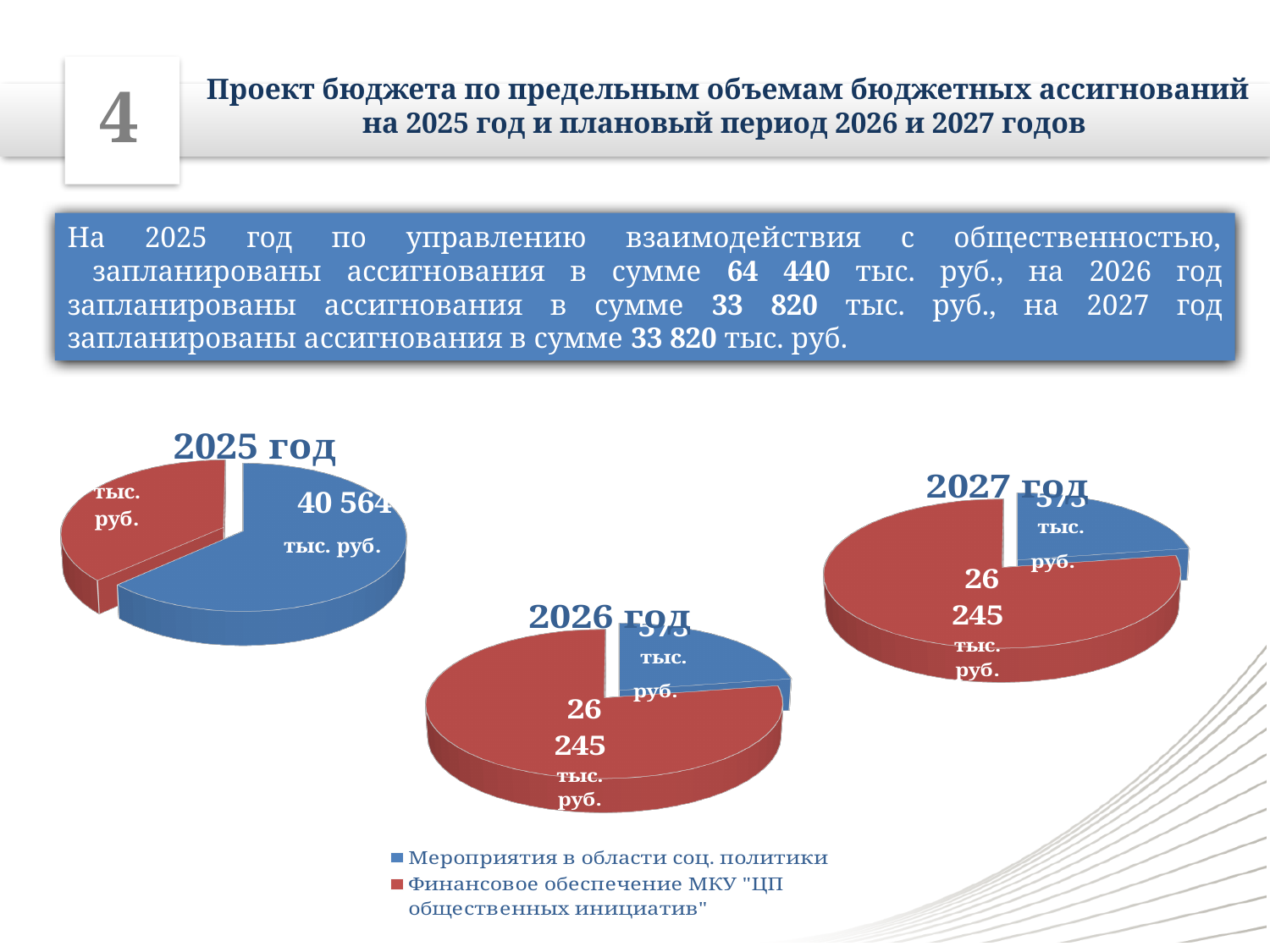
In the "2026 год" pie chart, what is the value for "Финансовое обеспечение МКУ "ЦП общественных инициатив""? 26 245 тыс. руб. In the "2025 год" pie chart, which category has the largest slice? Мероприятия в области соц. политики What colour represents "Финансовое обеспечение МКУ "ЦП общественных инициатив"" in the pie charts? Red In the "2025 год" pie chart, what is the value for "Мероприятия в области соц. политики"? 40 564 тыс. руб. How many pie charts are on the slide? 3 Which is larger: the value for "Мероприятия в области соц. политики" in the "2025 год" chart or the value for "Финансовое обеспечение МКУ "ЦП общественных инициатив"" in the "2026 год" chart? Мероприятия в области соц. политики in 2025 год How many series does the legend list? 2 In the "2027 год" pie chart, which category has the smallest slice? Мероприятия в области соц. политики In the "2027 год" pie chart, what is the value for "Финансовое обеспечение МКУ "ЦП общественных инициатив""? 26 245 тыс. руб. What kind of charts are shown on the slide? Pie charts In the "2026 год" pie chart, which category has the largest slice? Финансовое обеспечение МКУ "ЦП общественных инициатив" How many slices does each pie chart have? 2